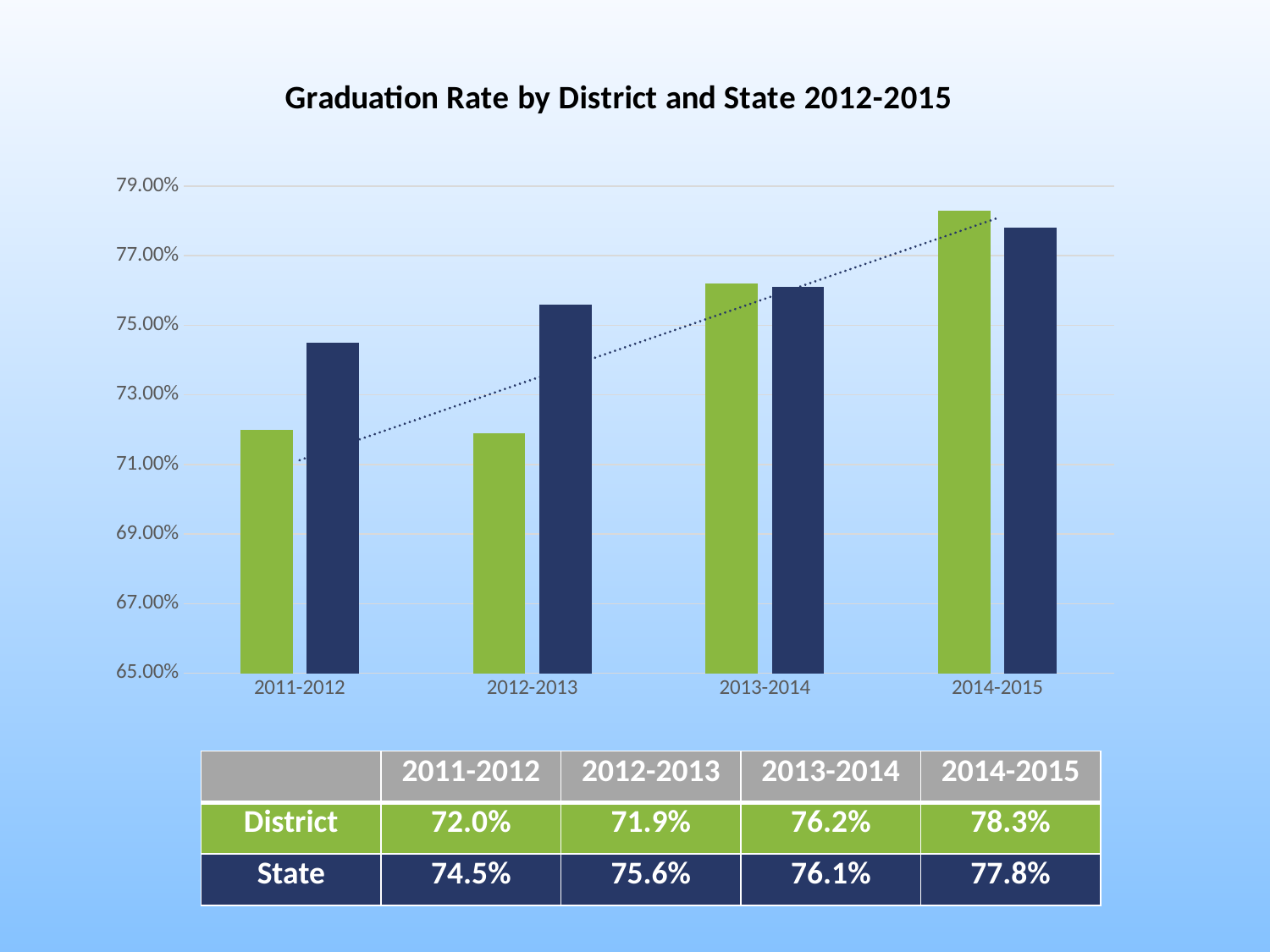
What kind of chart is shown on the slide? bar chart Does the State graduation rate rise or fall from 2011-2012 to 2014-2015? rise What is the State graduation rate for 2012-2013? 75.6% What is the District graduation rate for 2014-2015? 78.3% Which is larger in 2014-2015, the District rate or the State rate? District How many school years are shown on the x axis? 4 What is the title of the chart? Graduation Rate by District and State 2012-2015 In which year is the State graduation rate highest? 2014-2015 What is the difference between the State and District graduation rates in 2011-2012? 2.5% In which year is the District graduation rate lowest? 2012-2013 How many data series does the chart show? 2 Is the District graduation rate for 2013-2014 greater or less than 75.00%? greater